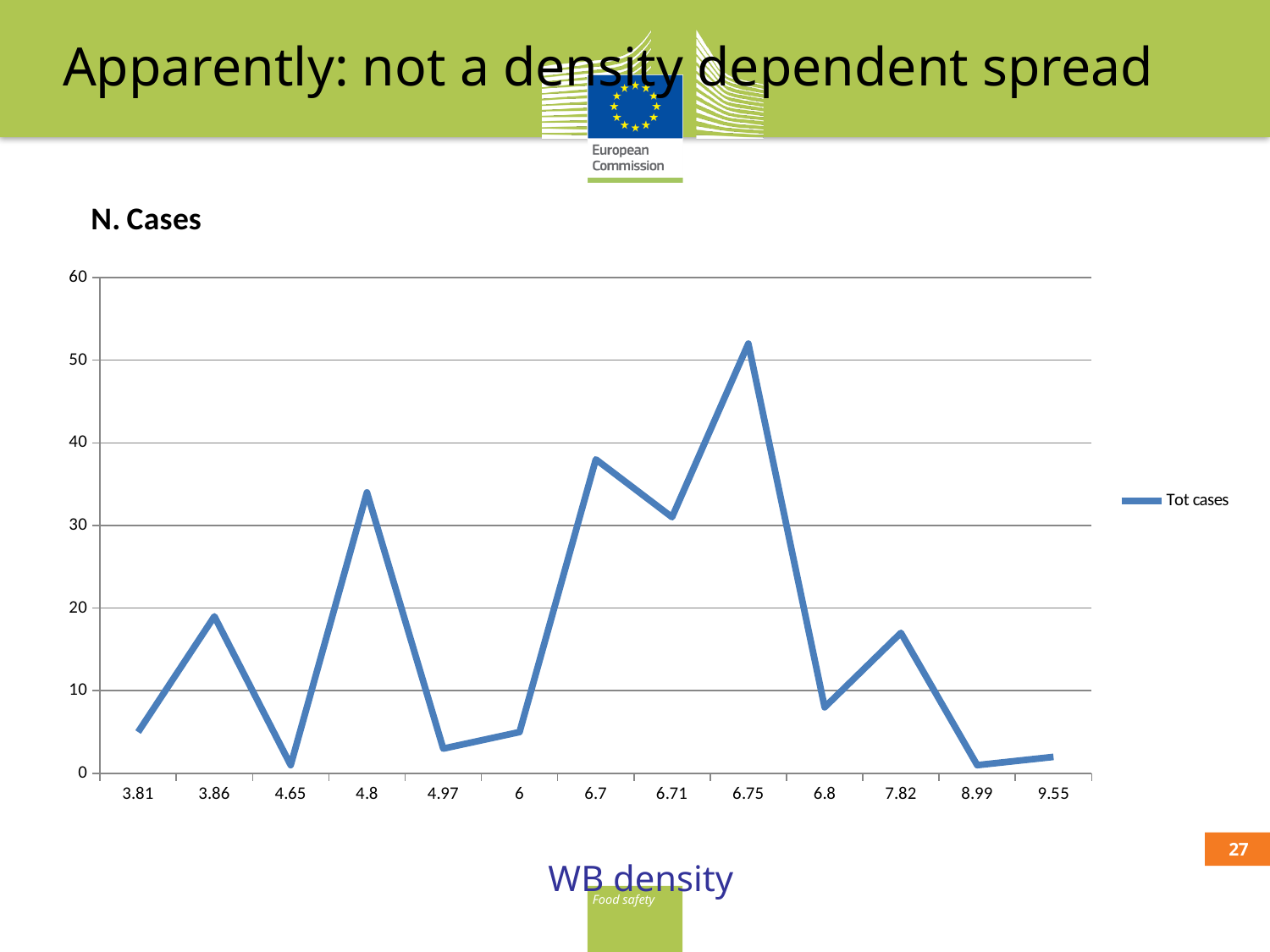
Is the value for 6.8 greater or less than 10? less Which has a higher value, 6.7 or 6.71? 6.7 How many series does the legend list? 1 Is the value for 6.75 greater or less than 50? greater Which has a higher value, 6.75 or 4.8? 6.75 At which WB density value is the number of cases highest? 6.75 How many data points are plotted along the x axis? 13 Is the value for 4.8 greater or less than 30? greater What is the name of the series shown in the legend? Tot cases What kind of chart is shown on the slide? line chart Do the values rise or fall from 6.75 to 8.99 along the x axis? fall